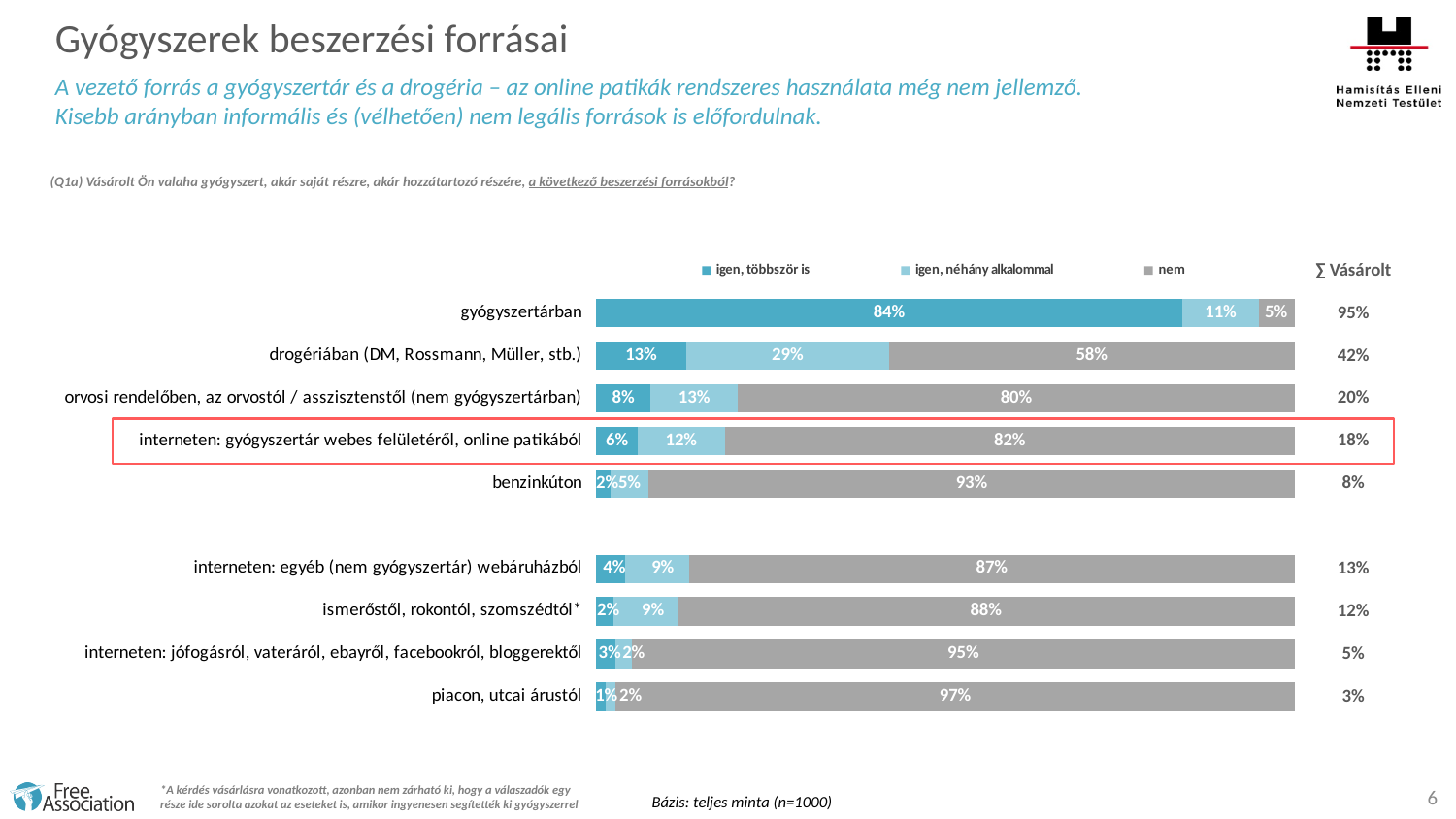
What is the value of "igen, többször is" for gyógyszertárban? 84% What is the value of "igen, néhány alkalommal" for orvosi rendelőben, az orvostól / asszisztenstől (nem gyógyszertárban)? 13% What kind of chart is shown on the slide? Stacked bar chart Which has a larger "igen, néhány alkalommal" value: drogériában (DM, Rossmann, Müller, stb.) or orvosi rendelőben, az orvostól / asszisztenstől (nem gyógyszertárban)? drogériában (DM, Rossmann, Müller, stb.) What is the ∑ Vásárolt value for interneten: gyógyszertár webes felületéről, online patikából? 18% What is the difference between the "igen, többször is" values for gyógyszertárban and drogériában (DM, Rossmann, Müller, stb.)? 71 percentage points Which category is highlighted with a red box on the chart? interneten: gyógyszertár webes felületéről, online patikából How many series does the legend list? 3 What is the value of "nem" for drogériában (DM, Rossmann, Müller, stb.)? 58% Which category has the highest value for "nem"? piacon, utcai árustól How many categories (purchase sources) are shown in the chart? 9 Which category has the lowest ∑ Vásárolt value? piacon, utcai árustól